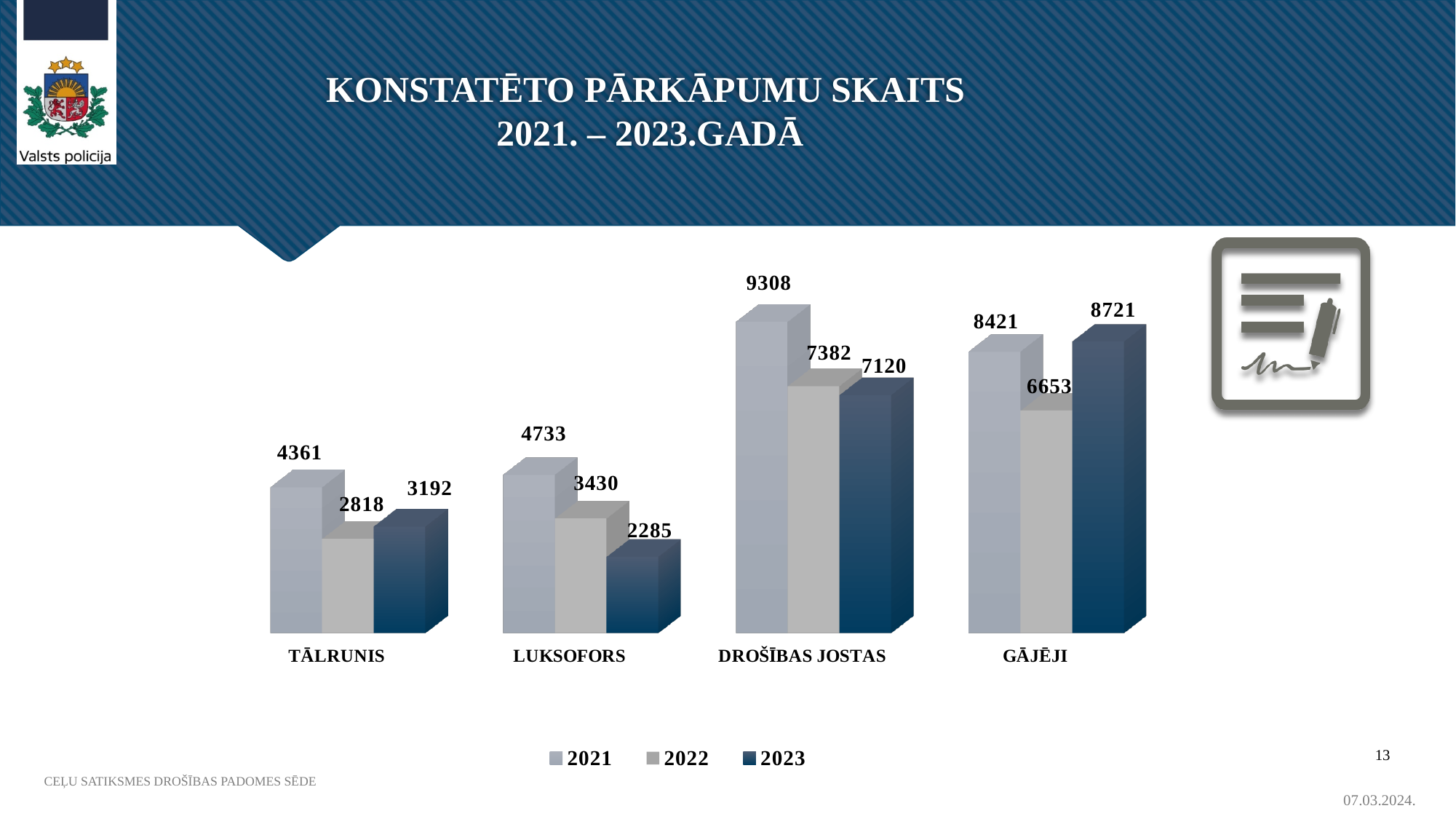
What is the value for GĀJĒJI in 2023? 8721 How many categories are shown on the x axis? 4 What is the difference between the 2021 and 2023 values for DROŠĪBAS JOSTAS? 2188 What is the difference between the 2023 and 2022 values for GĀJĒJI? 2068 Which category has the highest value in 2021? DROŠĪBAS JOSTAS What kind of chart is shown on the slide? bar chart What is the value for TĀLRUNIS in 2021? 4361 Which is larger for TĀLRUNIS: the 2022 value or the 2023 value? 2023 Which category has the lowest value in 2023? LUKSOFORS What is the value for LUKSOFORS in 2023? 2285 What is the value for DROŠĪBAS JOSTAS in 2022? 7382 How many series does the legend list? 3